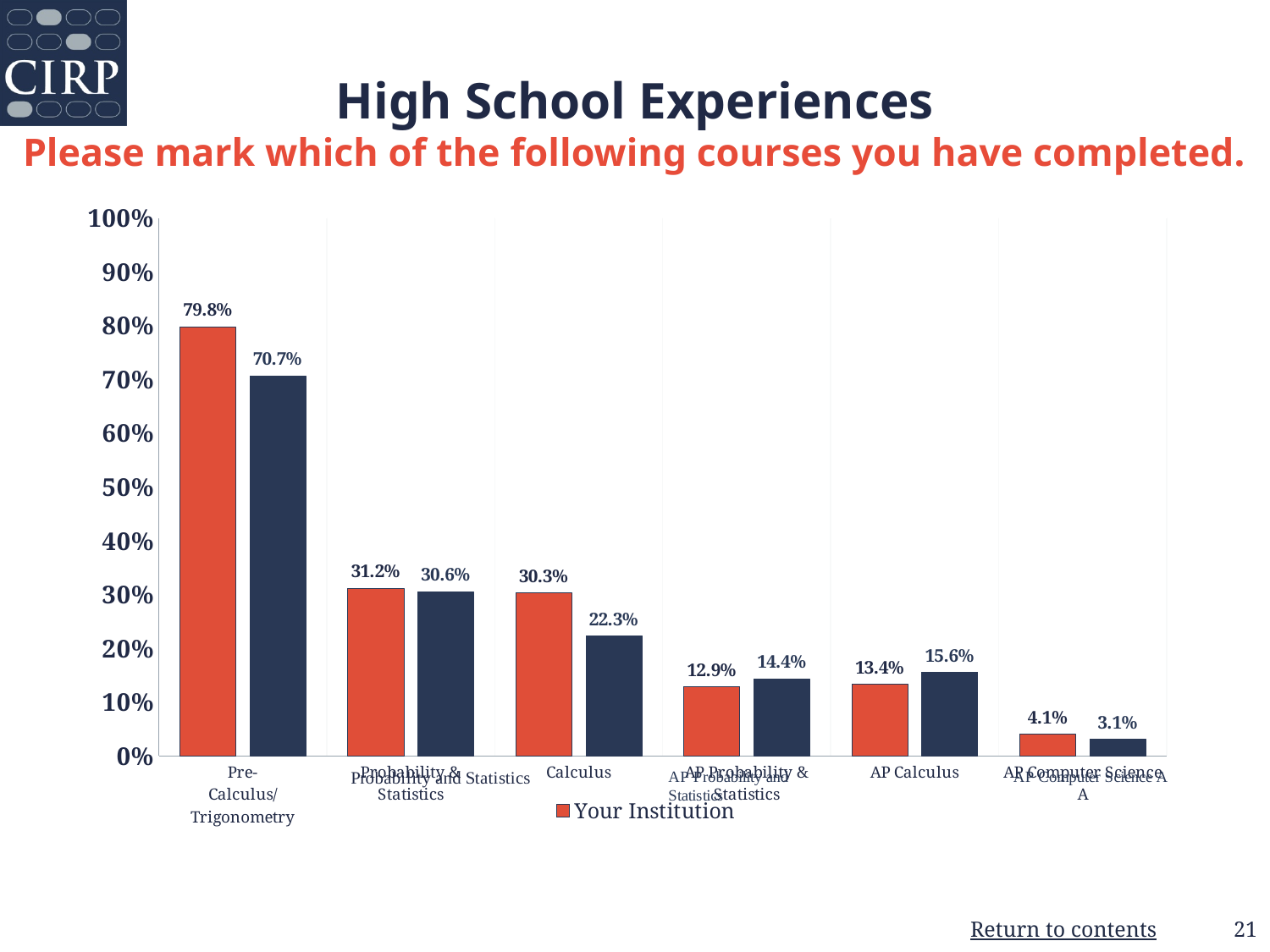
Is the dark blue bar for Pre-Calculus/Trigonometry greater or less than 60%? greater What is the title of the slide? High School Experiences What is the value of the dark blue bar for Calculus? 22.3% Which course has the lowest value for Your Institution? AP Computer Science A What is the difference between the Your Institution bar and the dark blue bar for Pre-Calculus/Trigonometry? 9.1 percentage points What is the difference between the Your Institution bar and the dark blue bar for Calculus? 8.0 percentage points What is the value for Your Institution for Pre-Calculus/Trigonometry? 79.8% How many courses are shown on the x axis? 6 What kind of chart is shown on the slide? Bar chart What is the value for Your Institution for AP Probability & Statistics? 12.9% Which course has the highest value for Your Institution? Pre-Calculus/Trigonometry For AP Calculus, which is larger: the Your Institution bar or the dark blue bar? The dark blue bar